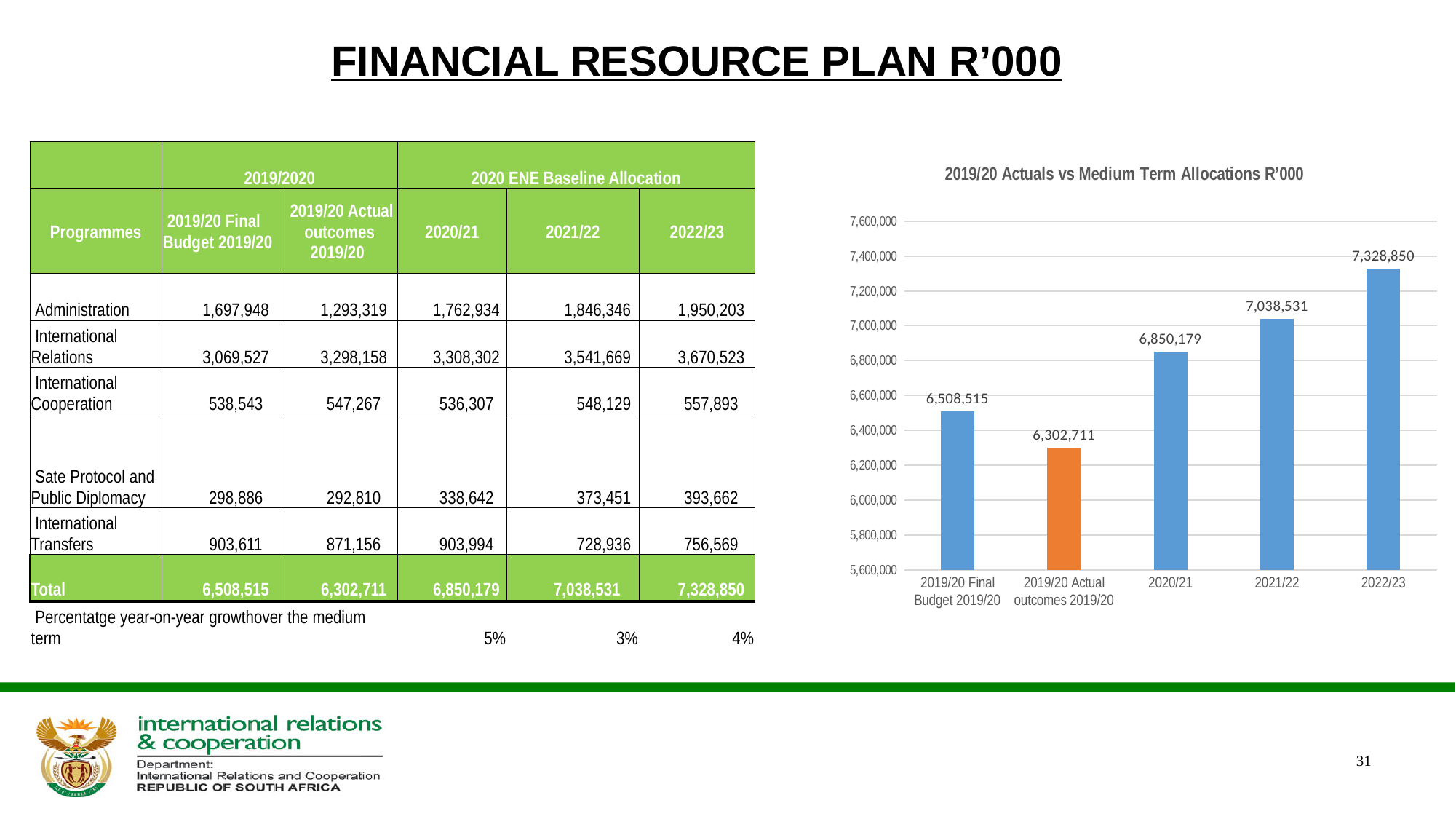
What type of chart is shown on the slide? Bar chart Is the value for 2020/21 greater or less than 7,000,000? less Which is larger, the value for 2021/22 or the value for 2020/21? 2021/22 What is the value for 2022/23 in the chart? 7,328,850 Which category has the lowest value in the chart? 2019/20 Actual outcomes 2019/20 Which bar in the chart is coloured orange? 2019/20 Actual outcomes 2019/20 What is the value for 2019/20 Actual outcomes 2019/20 in the chart? 6,302,711 What is the difference between the 2019/20 Final Budget 2019/20 and the 2019/20 Actual outcomes 2019/20? 205,804 What is the difference between the values for 2022/23 and 2021/22? 290,319 Which category has the highest value in the chart? 2022/23 What is the value for 2020/21 in the chart? 6,850,179 How many bars are plotted in the chart? 5